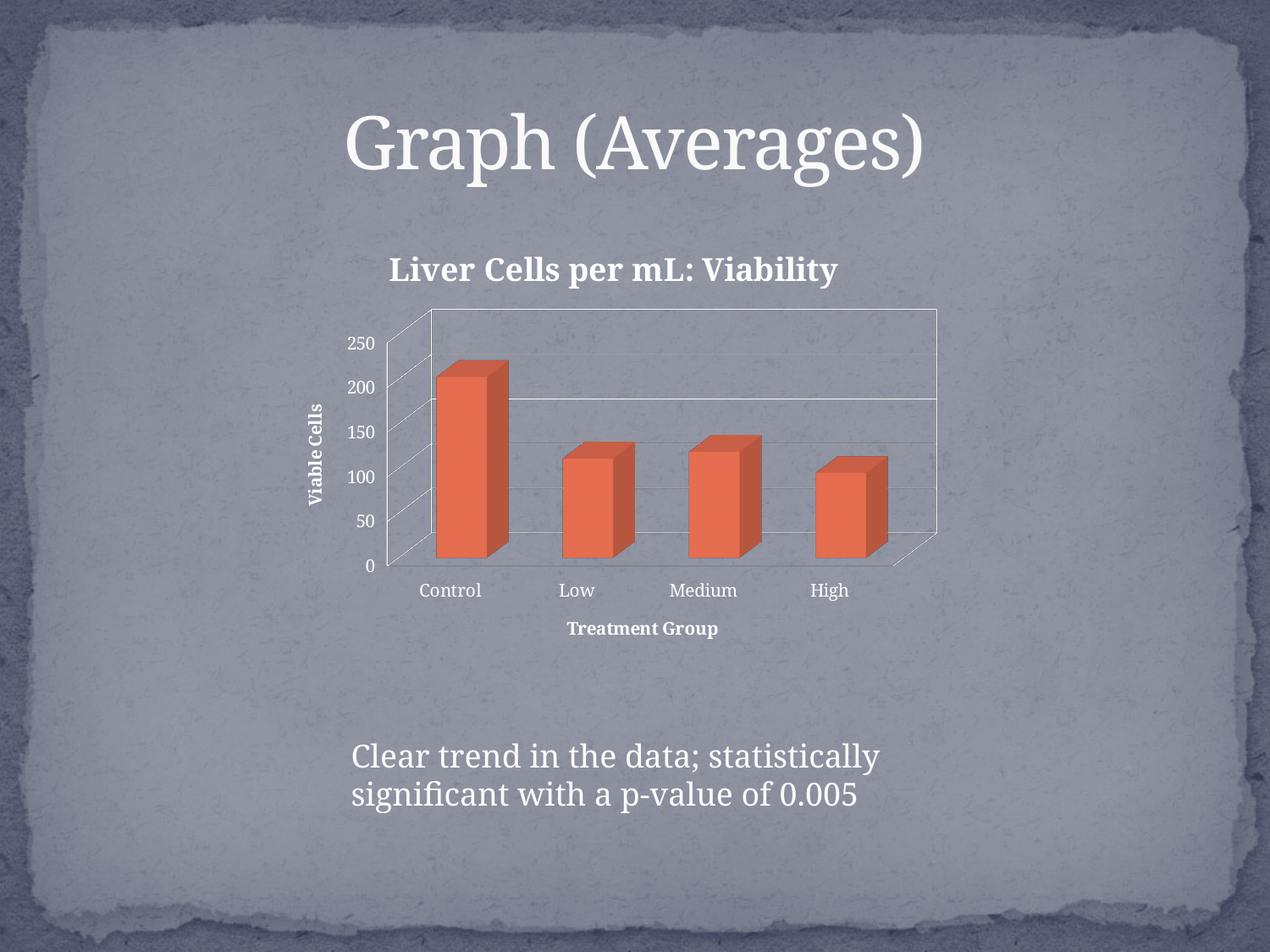
Is the value for High greater or less than 150? less Is the value for Medium greater or less than 200? less Which treatment group has the lowest number of viable cells? High What type of chart is shown on the slide? Bar chart Is the value for Low greater or less than 150? less What is the label on the vertical axis of the chart? Viable Cells What is the title of the chart? Liver Cells per mL: Viability Which has more viable cells, Medium or High? Medium How many treatment groups are shown on the x axis of the chart? 4 Which has more viable cells, Control or High? Control Which treatment group has the highest number of viable cells? Control